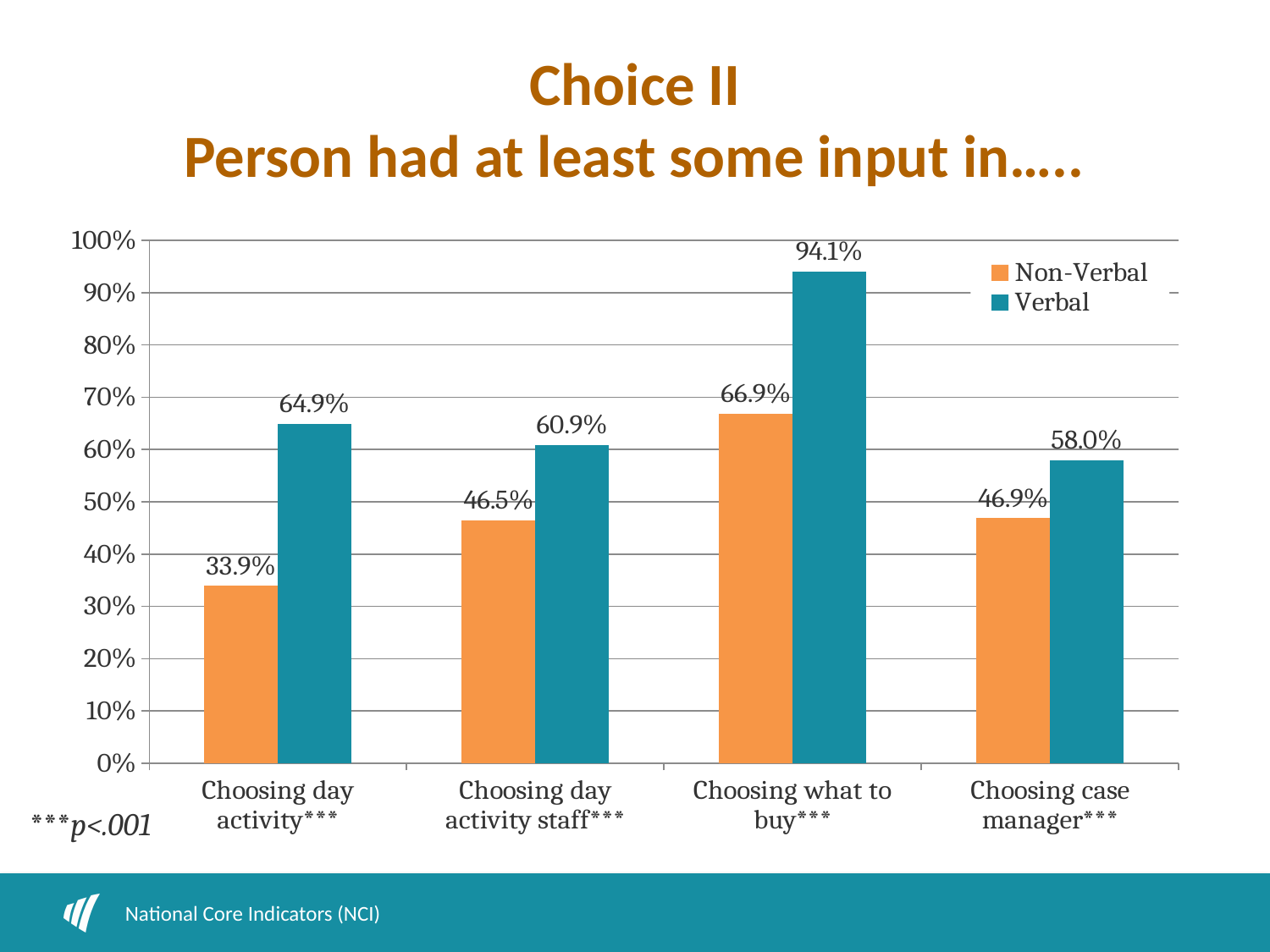
How many categories are shown on the x axis? 4 What is the Verbal value for Choosing case manager? 58.0% What is the Non-Verbal value for Choosing day activity? 33.9% Which is larger, the Non-Verbal value for Choosing what to buy or the Verbal value for Choosing day activity? Non-Verbal value for Choosing what to buy What is the Verbal value for Choosing what to buy? 94.1% What is the difference between the Verbal and Non-Verbal values for Choosing what to buy? 27.2% Which category has the lowest Non-Verbal value? Choosing day activity How many series does the legend list? 2 What is the difference between the Verbal and Non-Verbal values for Choosing day activity? 31.0% What kind of chart is shown on the slide? Bar chart Which category has the highest Verbal value? Choosing what to buy What is the Non-Verbal value for Choosing day activity staff? 46.5%